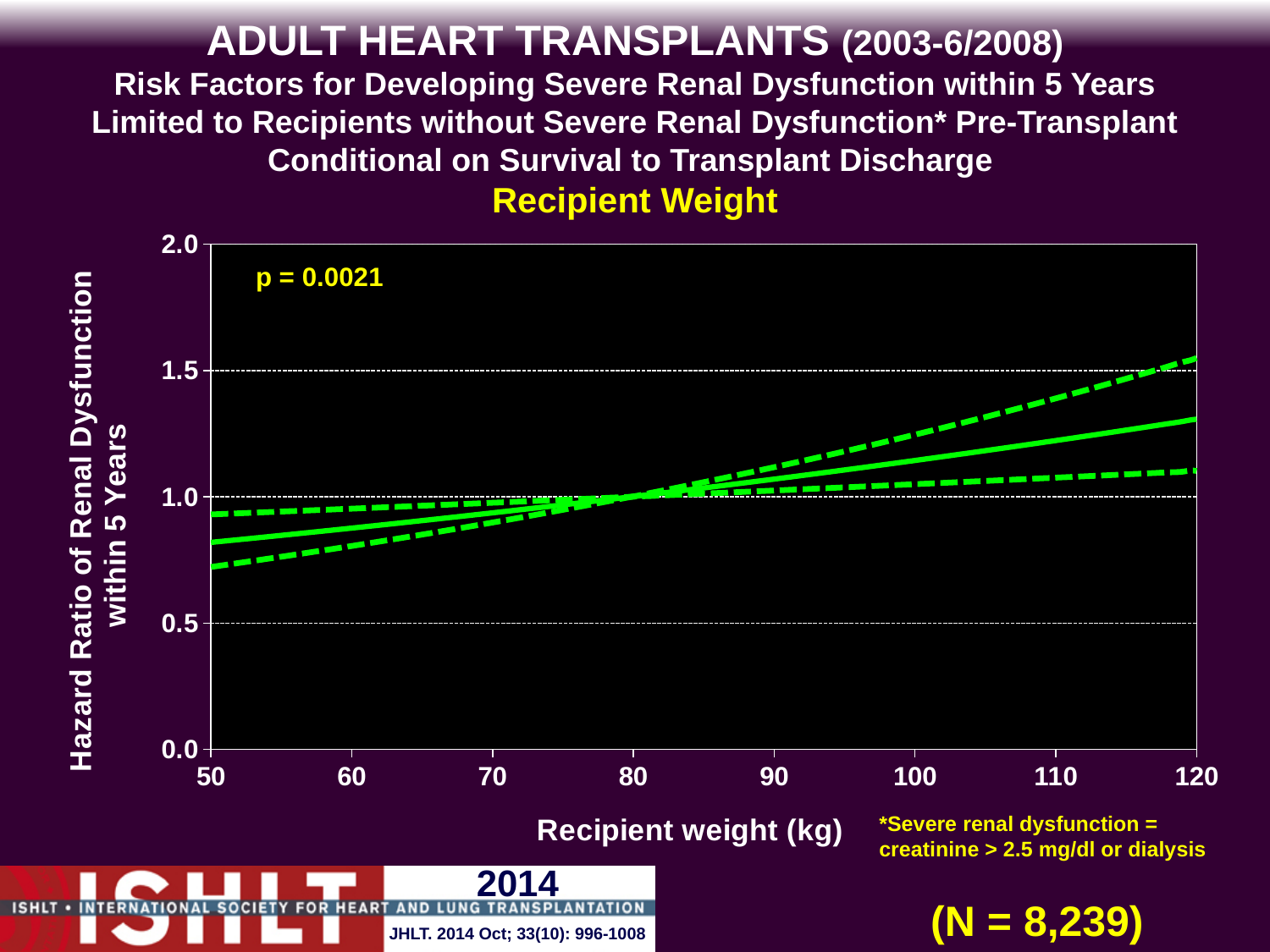
Is the hazard ratio on the solid line at a recipient weight of 50 kg greater or less than 1.0? less Does the solid hazard ratio line rise or fall as recipient weight increases from 50 kg to 120 kg? rise Is the lower dashed line at a recipient weight of 50 kg greater or less than 0.5? greater How many lines are plotted on the chart? 3 Which is larger on the solid line: the hazard ratio at 60 kg or at 110 kg? 110 kg What is the sample size (N) shown on the slide? N = 8,239 Is the hazard ratio on the solid line at a recipient weight of 120 kg greater or less than 1.0? greater What kind of chart is shown on the slide? line chart What p-value is printed on the chart? p = 0.0021